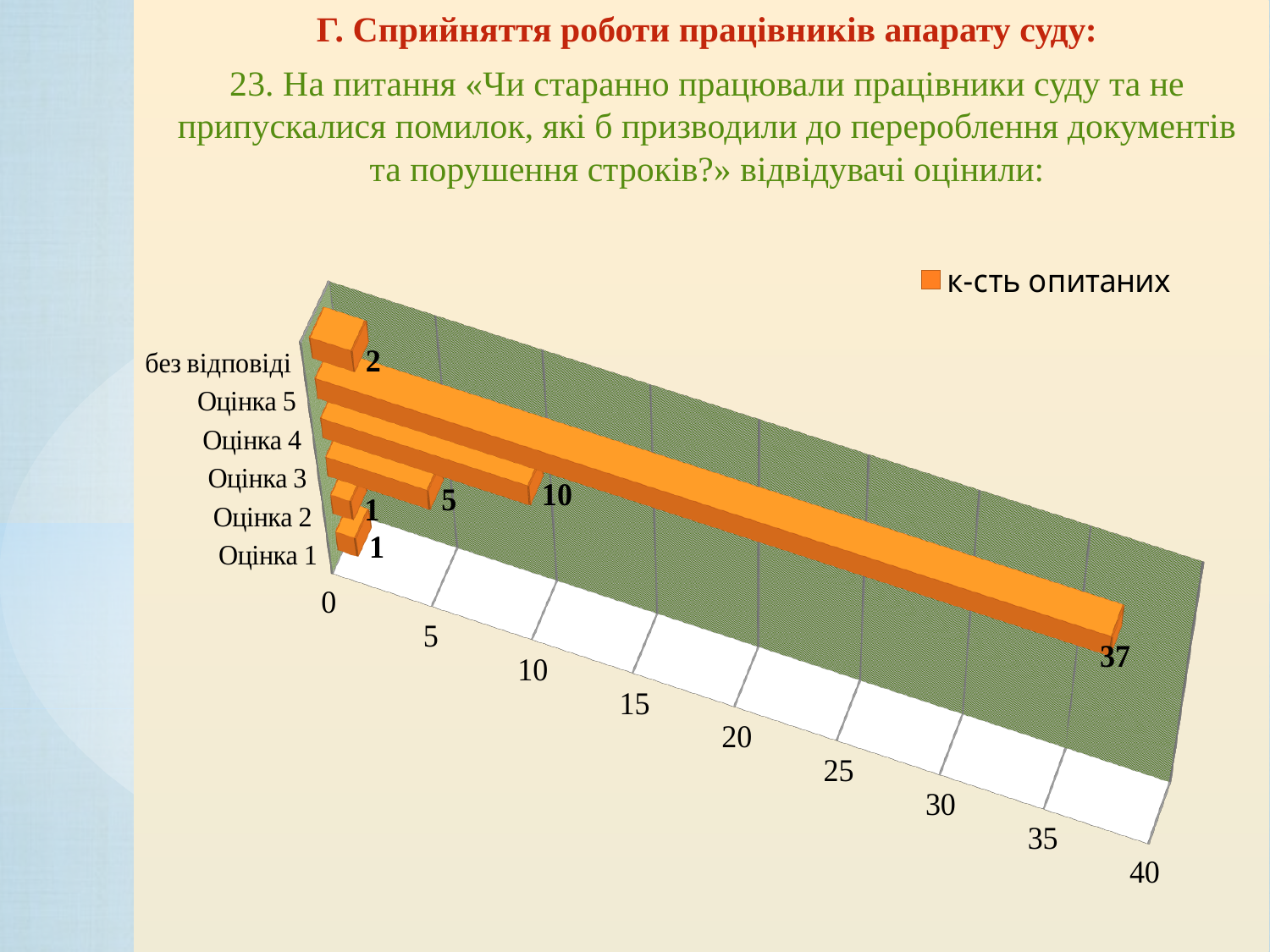
What is the value for Оцінка 4? 10 Which is larger, the value for Оцінка 3 or the value for без відповіді? Оцінка 3 What is the value for Оцінка 5? 37 What is the difference between the values for Оцінка 4 and Оцінка 3? 5 How many categories are shown on the chart? 6 What is the value for Оцінка 3? 5 Which category has the highest value? Оцінка 5 How many series does the legend list? 1 What is the value for без відповіді? 2 What is the value for Оцінка 1? 1 What kind of chart is shown on the slide? bar chart What is the difference between the values for Оцінка 5 and Оцінка 4? 27